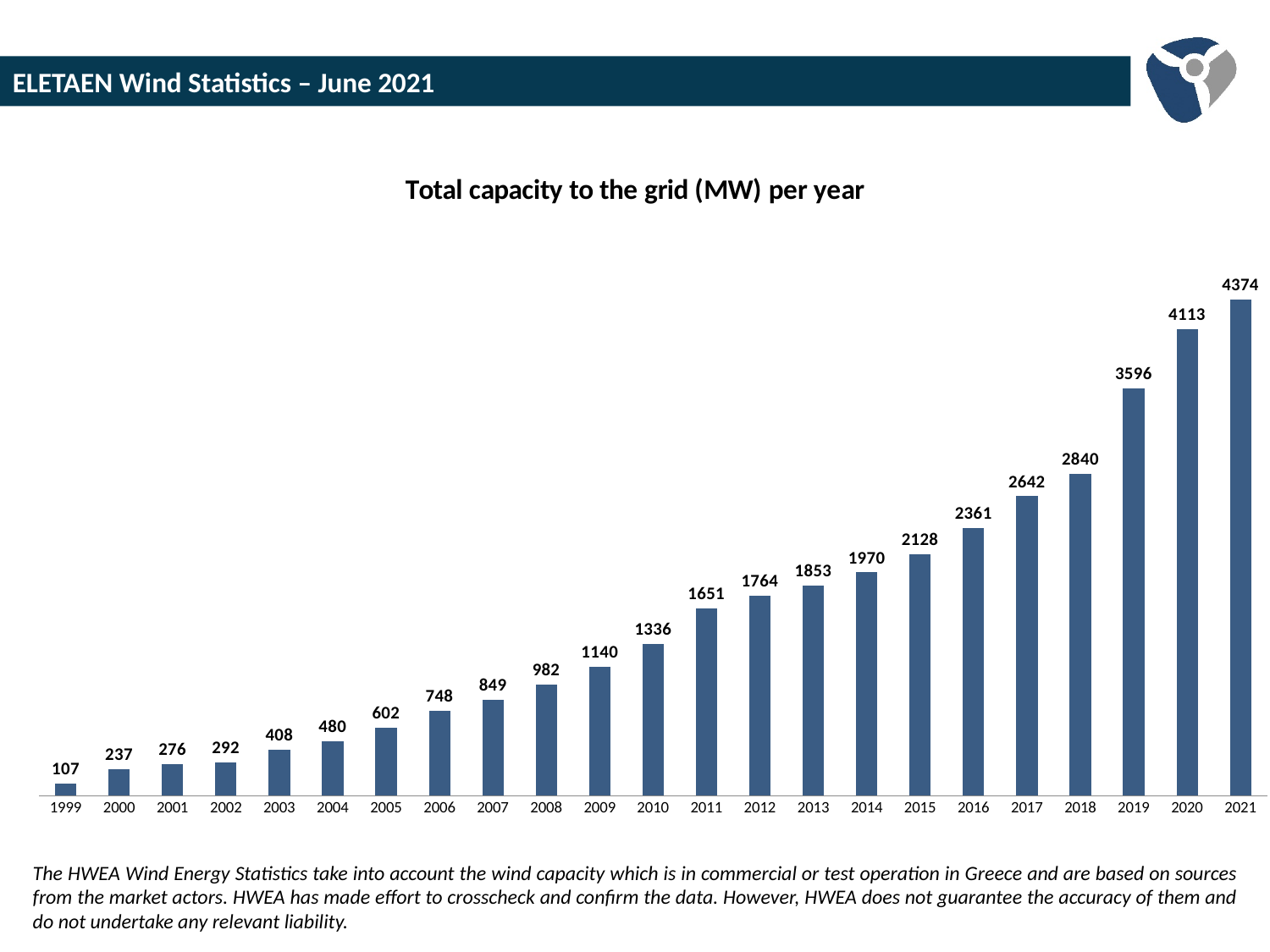
What is the total capacity to the grid in 2010? 1336 How many years are shown on the x axis of the chart? 23 What is the total capacity to the grid in 1999? 107 Which year has a larger total capacity, 2005 or 2008? 2008 Which year has the highest total capacity to the grid? 2021 What is the difference in total capacity between 2019 and 2018? 756 Which year has the lowest total capacity to the grid? 1999 What is the title of the chart? Total capacity to the grid (MW) per year What kind of chart is shown on the slide? Bar chart Do the values rise or fall from 1999 to 2021? Rise What is the difference in total capacity between 2021 and 2020? 261 What is the total capacity to the grid in 2021? 4374